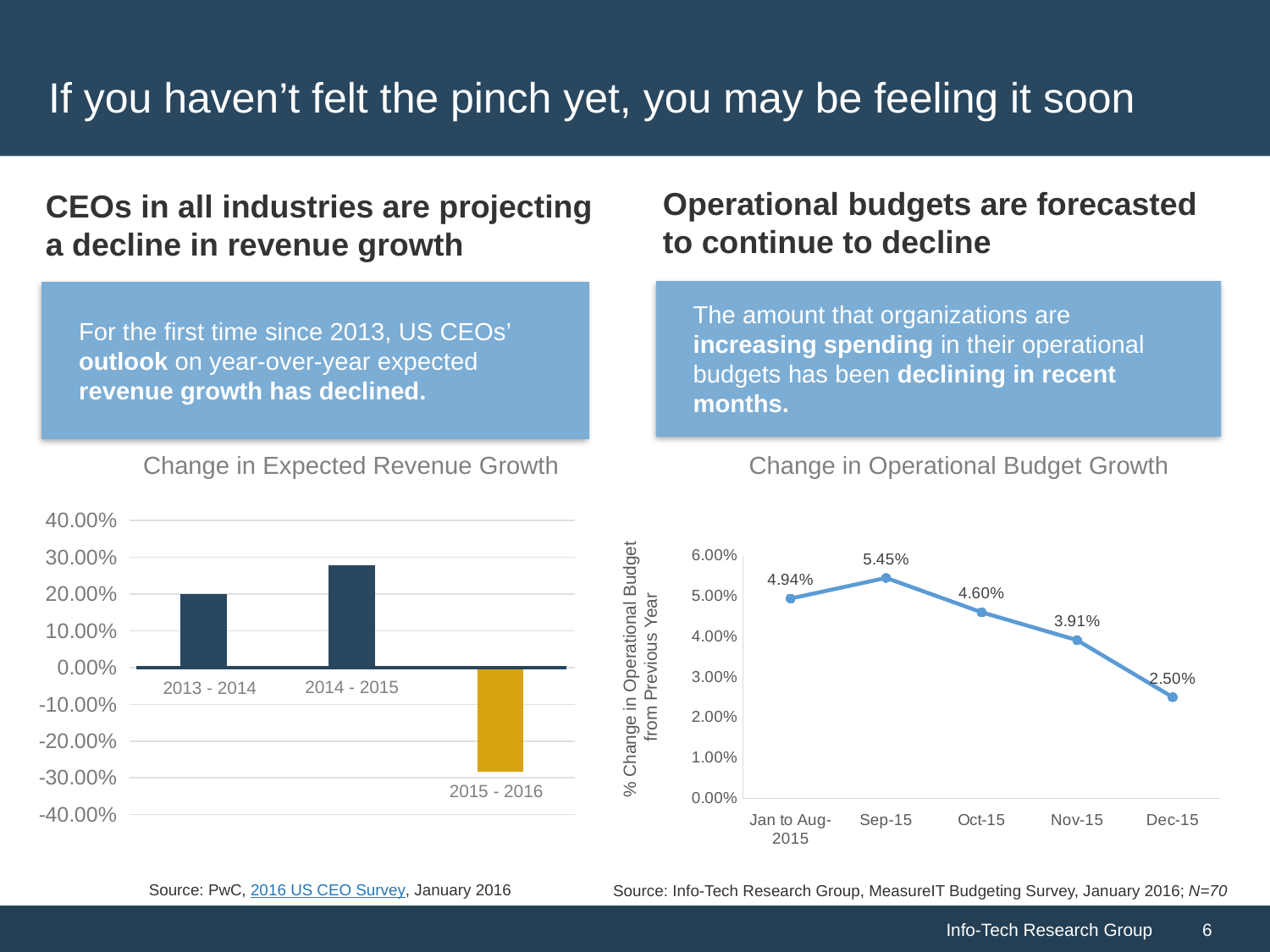
In the 'Change in Operational Budget Growth' chart, what is the difference between the Sep-15 and Dec-15 values? 2.95% In the 'Change in Operational Budget Growth' chart, how many data points are plotted? 5 In the 'Change in Operational Budget Growth' chart, which period has the lowest value? Dec-15 What kind of chart is 'Change in Expected Revenue Growth'? bar chart In the 'Change in Operational Budget Growth' chart, what is the value for Dec-15? 2.50% In the 'Change in Expected Revenue Growth' chart, which category has the lowest value? 2015 - 2016 In the 'Change in Operational Budget Growth' chart, what is the value for Jan to Aug-2015? 4.94% In the 'Change in Operational Budget Growth' chart, which period has the highest value? Sep-15 In the 'Change in Operational Budget Growth' chart, what is the value for Sep-15? 5.45% In the 'Change in Expected Revenue Growth' chart, how many categories are shown? 3 In the 'Change in Operational Budget Growth' chart, do the values rise or fall from Sep-15 to Dec-15? fall In the 'Change in Expected Revenue Growth' chart, is the value for 2014 - 2015 greater or less than 20.00%? greater